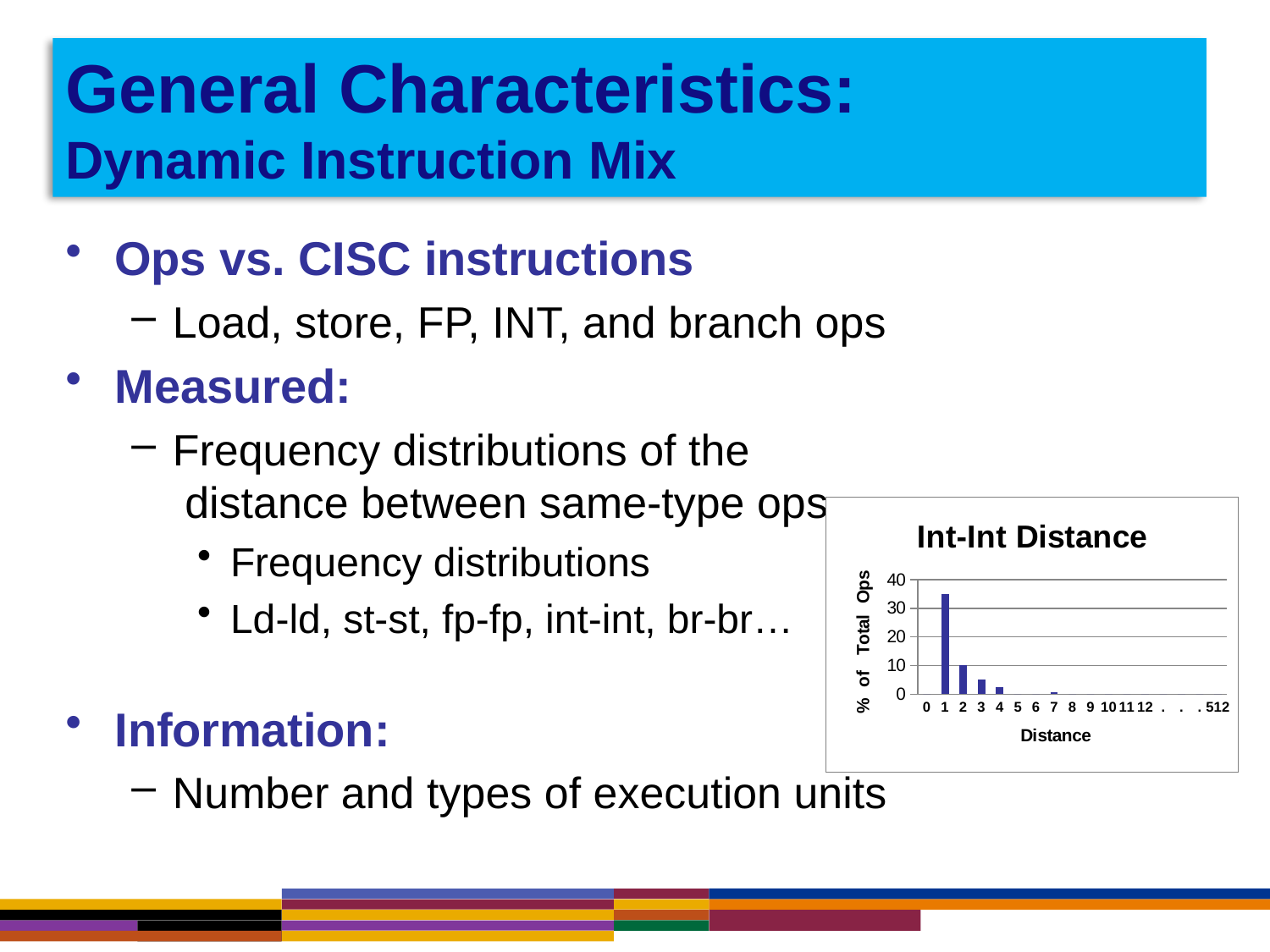
In the Int-Int Distance chart, which is larger, the value for distance 1 or distance 2? distance 1 In the Int-Int Distance chart, is the value for distance 1 greater or less than 30? greater In the Int-Int Distance chart, is the value for distance 1 greater or less than 40? less What is the label of the x axis of the Int-Int Distance chart? Distance In the Int-Int Distance chart, do the values rise or fall as distance increases from 1 to 4? fall What kind of chart is the Int-Int Distance chart? bar chart In the Int-Int Distance chart, which is larger, the value for distance 2 or distance 3? distance 2 In the Int-Int Distance chart, is the value for distance 3 greater or less than 10? less In the Int-Int Distance chart, which distance has the highest % of Total Ops? 1 What is the title of the chart on the slide? Int-Int Distance